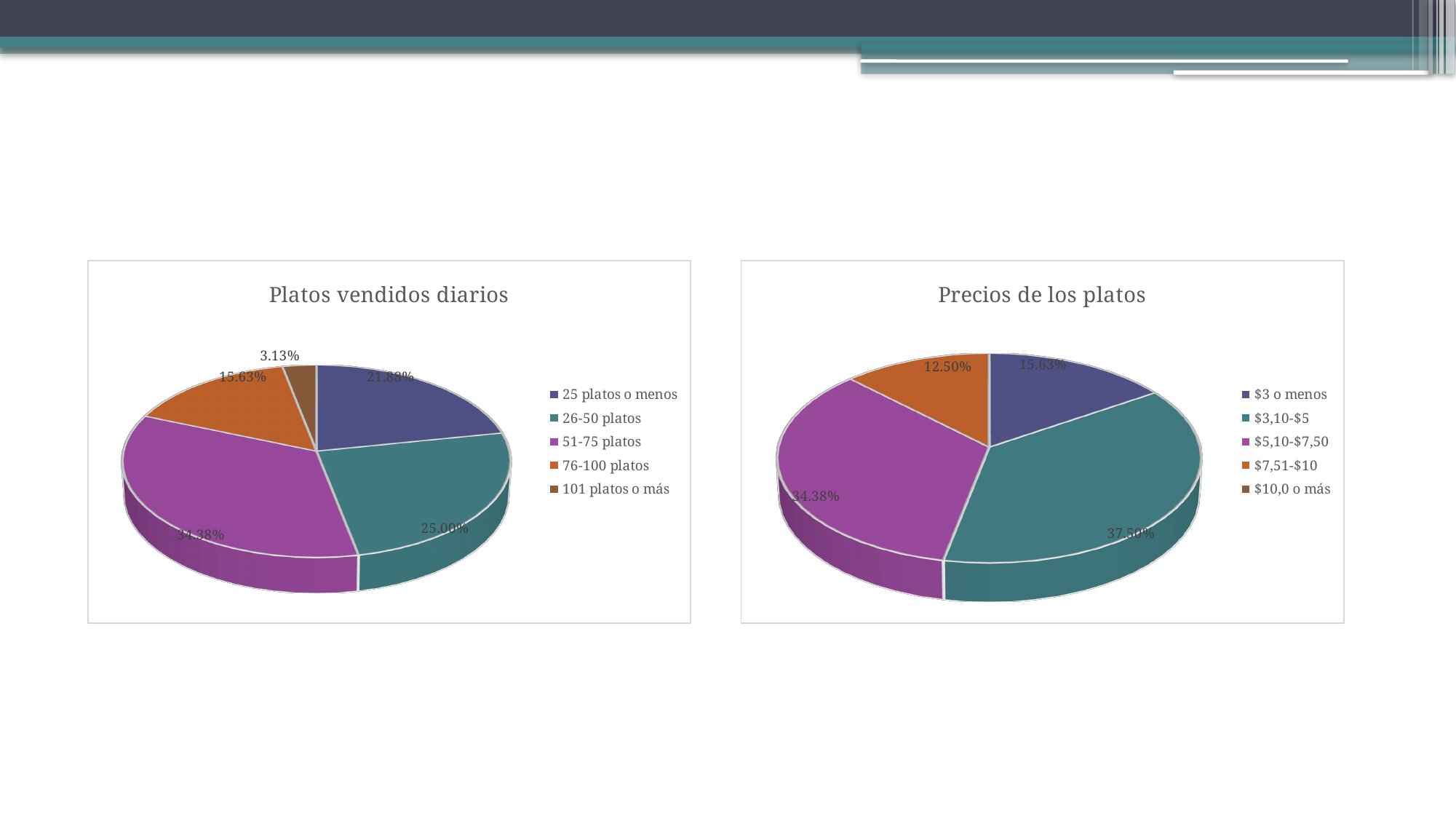
In the 'Platos vendidos diarios' chart, which category has the largest slice? 51-75 platos In the 'Precios de los platos' chart, which is larger, the share for '$3 o menos' or the share for '$7,51-$10'? $3 o menos In the 'Platos vendidos diarios' chart, which category has the smallest slice? 101 platos o más In the 'Platos vendidos diarios' chart, how many categories does the legend list? 5 In the 'Precios de los platos' chart, what share is shown for '$3,10-$5'? 37.50% What type of chart is 'Precios de los platos'? Pie chart In the 'Platos vendidos diarios' chart, what share is shown for '51-75 platos'? 34.38% In the 'Platos vendidos diarios' chart, what is the difference between the shares for '26-50 platos' and '25 platos o menos'? 3.12% In the 'Platos vendidos diarios' chart, what share is shown for '101 platos o más'? 3.13% In the 'Precios de los platos' chart, which category has the largest slice? $3,10-$5 In the 'Precios de los platos' chart, what colour is the '$5,10-$7,50' slice? Purple